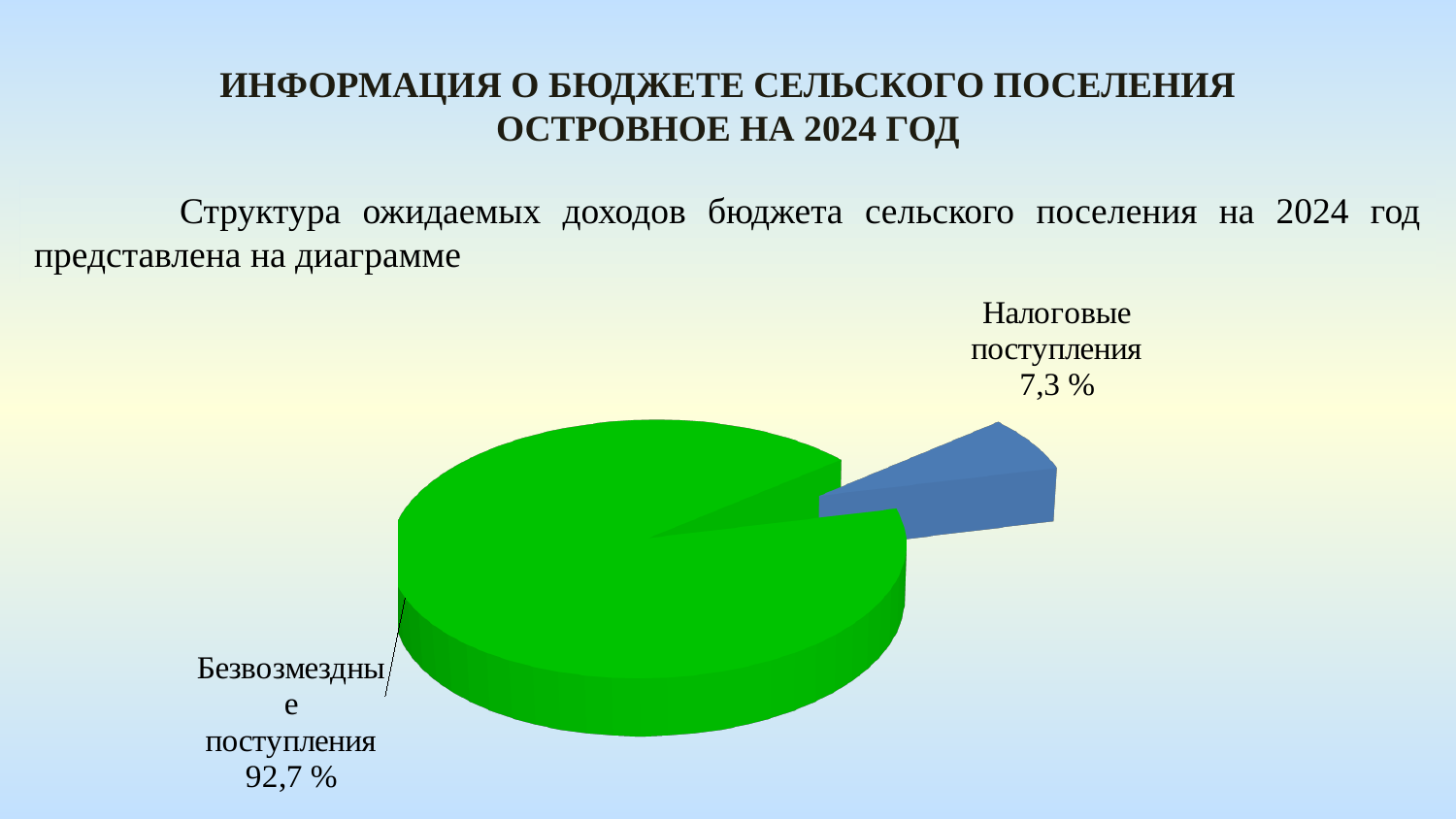
Which slice of the pie is the smallest? Налоговые поступления What share of the pie is labelled for Налоговые поступления? 7,3 % What is the total of the two labelled shares in the pie chart? 100 % Which is larger: Налоговые поступления or Безвозмездные поступления? Безвозмездные поступления Which slice of the pie is the largest? Безвозмездные поступления What is the difference in percentage points between Безвозмездные поступления and Налоговые поступления? 85,4 What share of the pie is labelled for Безвозмездные поступления? 92,7 % What colour is the slice for Налоговые поступления? blue What kind of chart is shown on the slide? pie chart What colour is the slice for Безвозмездные поступления? green How many slices does the pie chart have? 2